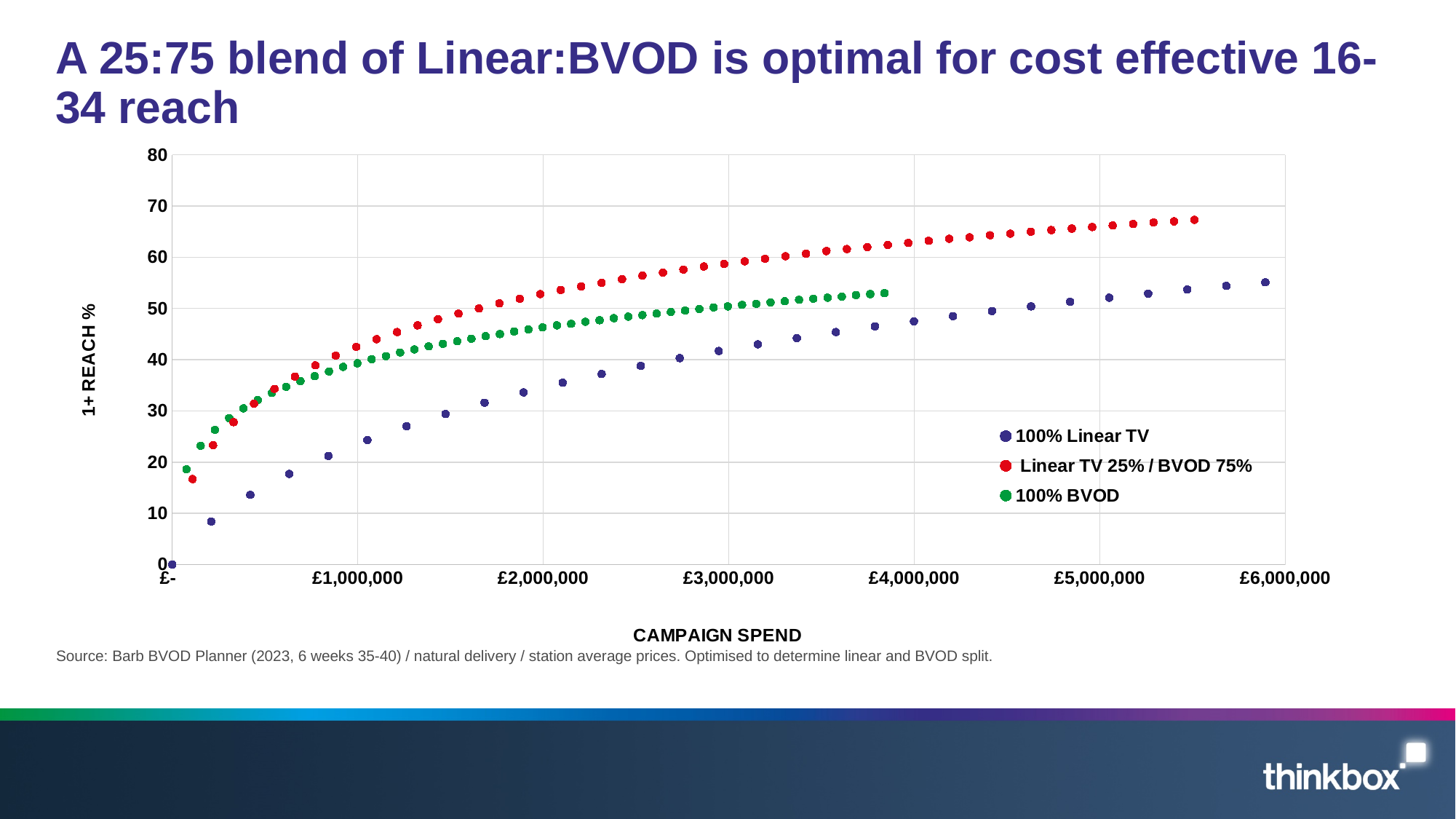
Is the highest value reached by the Linear TV 25% / BVOD 75% series greater or less than 60? greater Which series reaches the highest 1+ reach % on the chart? Linear TV 25% / BVOD 75% Is the highest value reached by the 100% Linear TV series greater or less than 60? less Which series has the lowest 1+ reach % at a campaign spend of £1,000,000? 100% Linear TV How many series does the legend list? 3 At a campaign spend of £3,000,000, which series has the higher 1+ reach %: 100% Linear TV or Linear TV 25% / BVOD 75%? Linear TV 25% / BVOD 75% Does the 1+ reach % for the 100% Linear TV series rise or fall as campaign spend increases? Rise Which series extends furthest along the campaign spend axis? 100% Linear TV Is the highest value reached by the 100% BVOD series greater or less than 60? less What is the title of the horizontal axis? CAMPAIGN SPEND What are the three series named in the legend? 100% Linear TV, Linear TV 25% / BVOD 75%, 100% BVOD What kind of chart is shown on the slide? Scatter chart